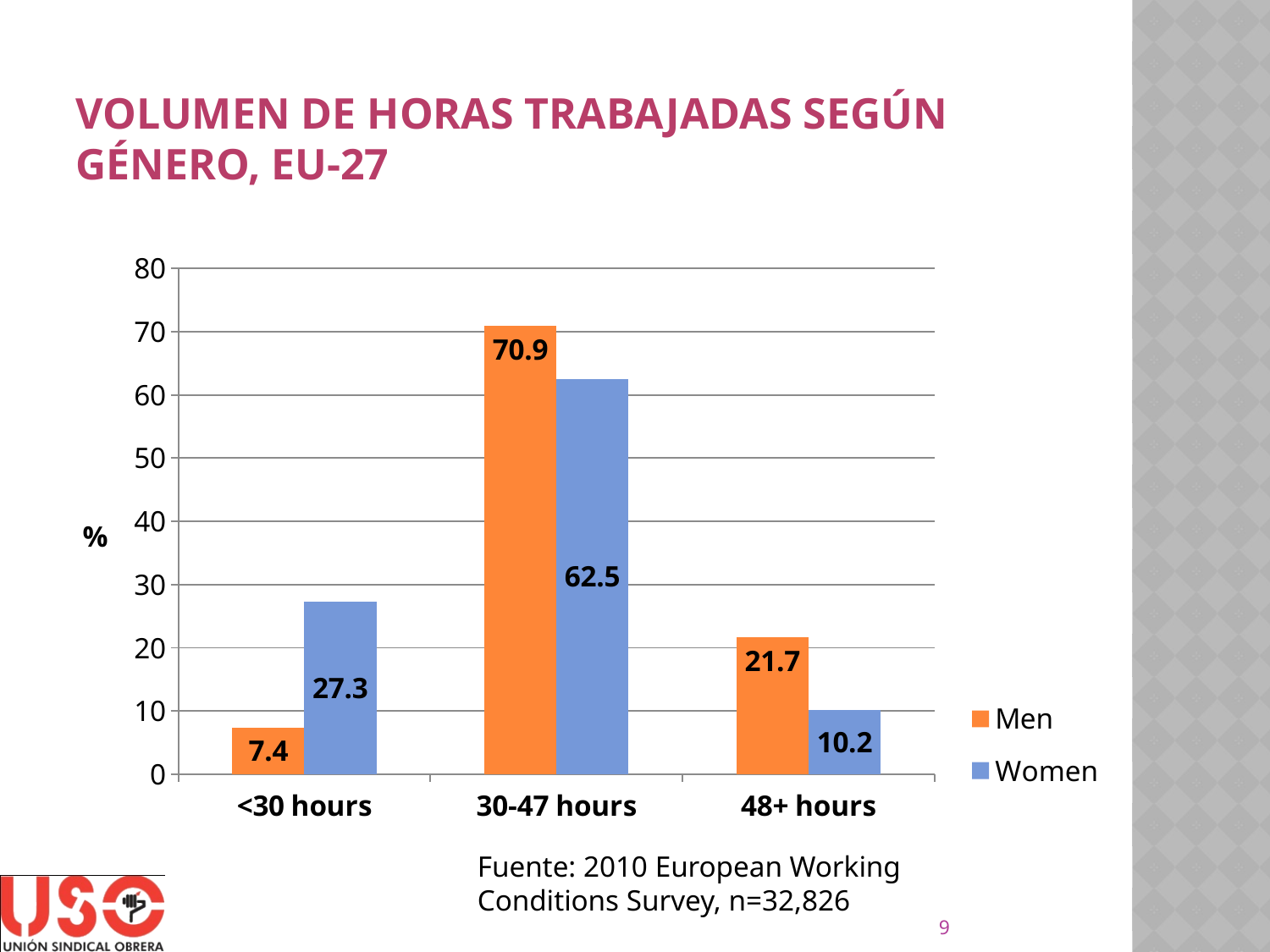
In the 48+ hours category, which series has the larger value, Men or Women? Men Which category has the highest value for Men? 30-47 hours What kind of chart is shown on the slide? Bar chart What is the difference between Women and Men in the <30 hours category? 19.9 Is the value for Men in the 30-47 hours category greater or less than 70? greater What is the value for Women in the 30-47 hours category? 62.5 How many series does the legend list? 2 What is the difference between Men and Women in the 30-47 hours category? 8.4 What is the value for Women in the 48+ hours category? 10.2 What is the value for Men in the <30 hours category? 7.4 How many categories are shown on the x axis? 3 Which category has the lowest value for Women? 48+ hours